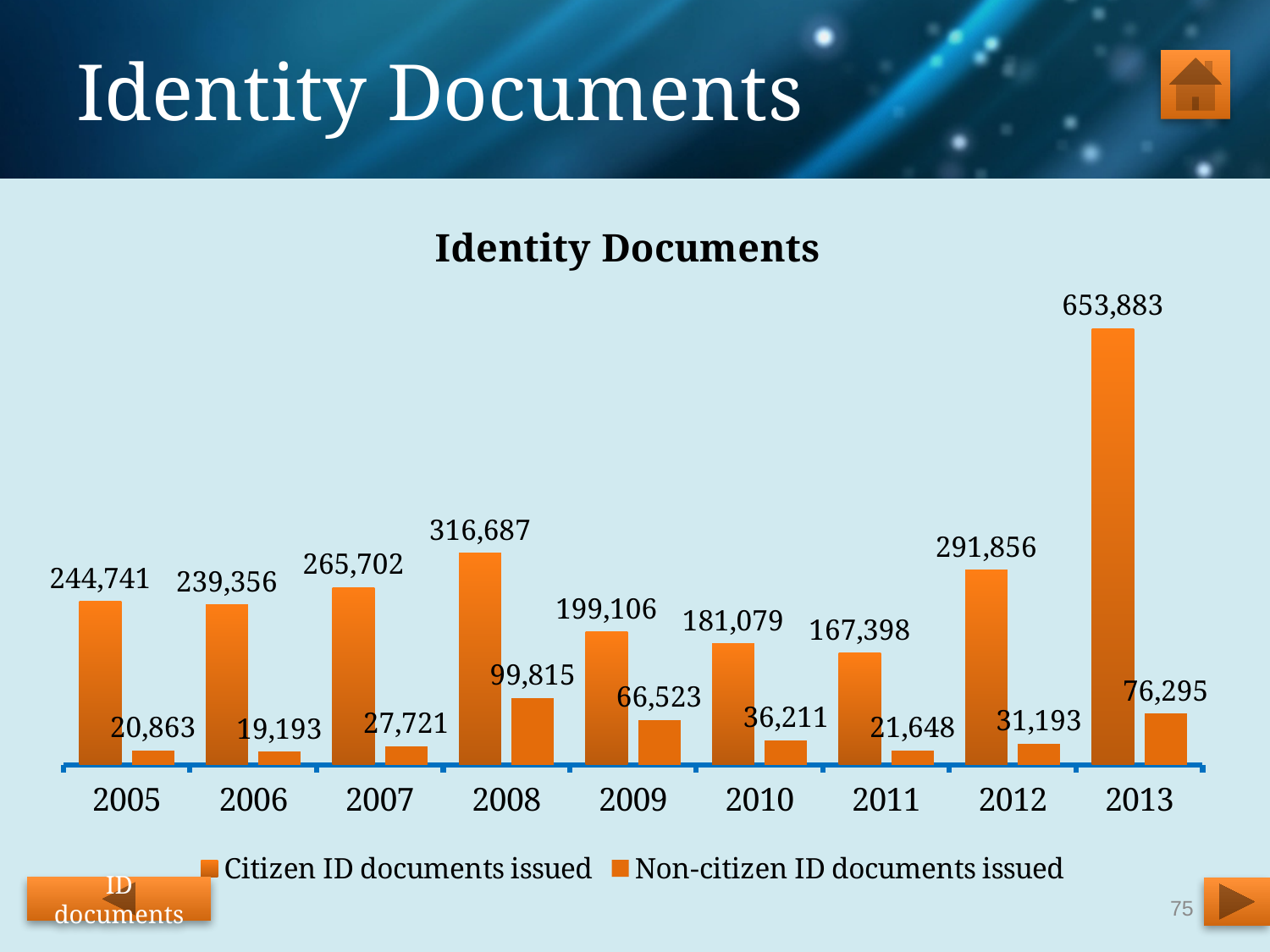
What type of chart is shown on the slide? Bar chart In which year were the most Citizen ID documents issued? 2013 How many series does the legend list? 2 How many Non-citizen ID documents were issued in 2009? 66,523 What is the total of Citizen and Non-citizen ID documents issued in 2005? 265,604 How many Citizen ID documents were issued in 2008? 316,687 In which year were the fewest Citizen ID documents issued? 2011 What is the difference between Citizen ID documents issued in 2013 and in 2012? 362,027 In which year were the fewest Non-citizen ID documents issued? 2006 Which is larger: Non-citizen ID documents issued in 2008 or in 2013? 2008 How many years are shown on the x axis? 9 What is the title of the chart? Identity Documents